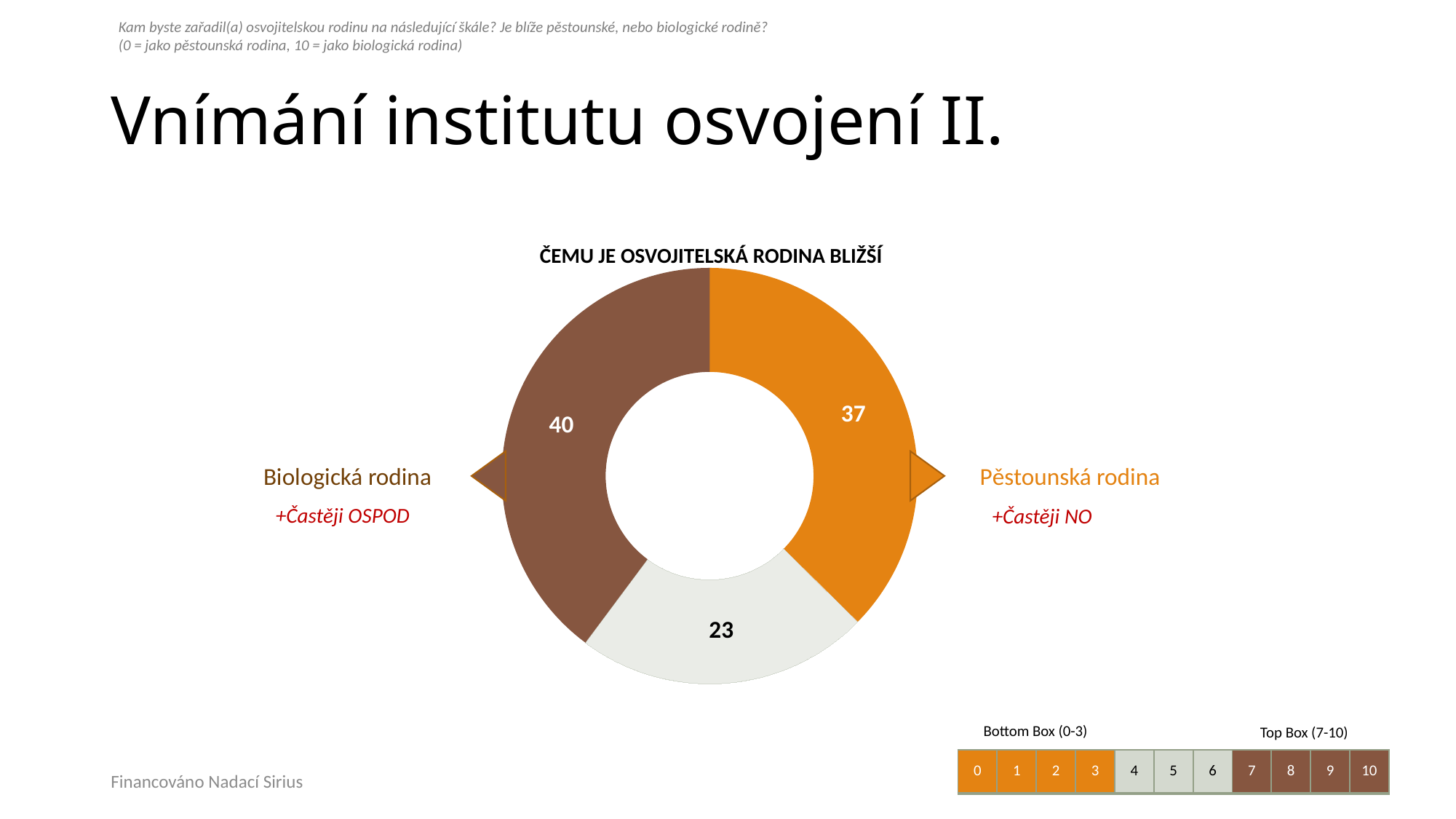
What is the difference between the Biologická rodina value and the Pěstounská rodina value? 3 What is the title of the donut chart? ČEMU JE OSVOJITELSKÁ RODINA BLIŽŠÍ What type of chart is shown on the slide? Donut (pie) chart What is the difference between the Pěstounská rodina value and the grey middle segment value? 14 How many segments does the donut chart have? 3 What value is shown for the grey middle segment (scale points 4-6) of the donut chart? 23 What value is shown for the Biologická rodina (brown) segment of the donut chart? 40 Which is larger: the value for Biologická rodina or the value for Pěstounská rodina? Biologická rodina What value is shown for the Pěstounská rodina (orange) segment of the donut chart? 37 Which segment of the donut chart has the lowest value? The grey middle segment (23) Which segment of the donut chart has the highest value? Biologická rodina (40) What is the total of the three values shown in the donut chart? 100